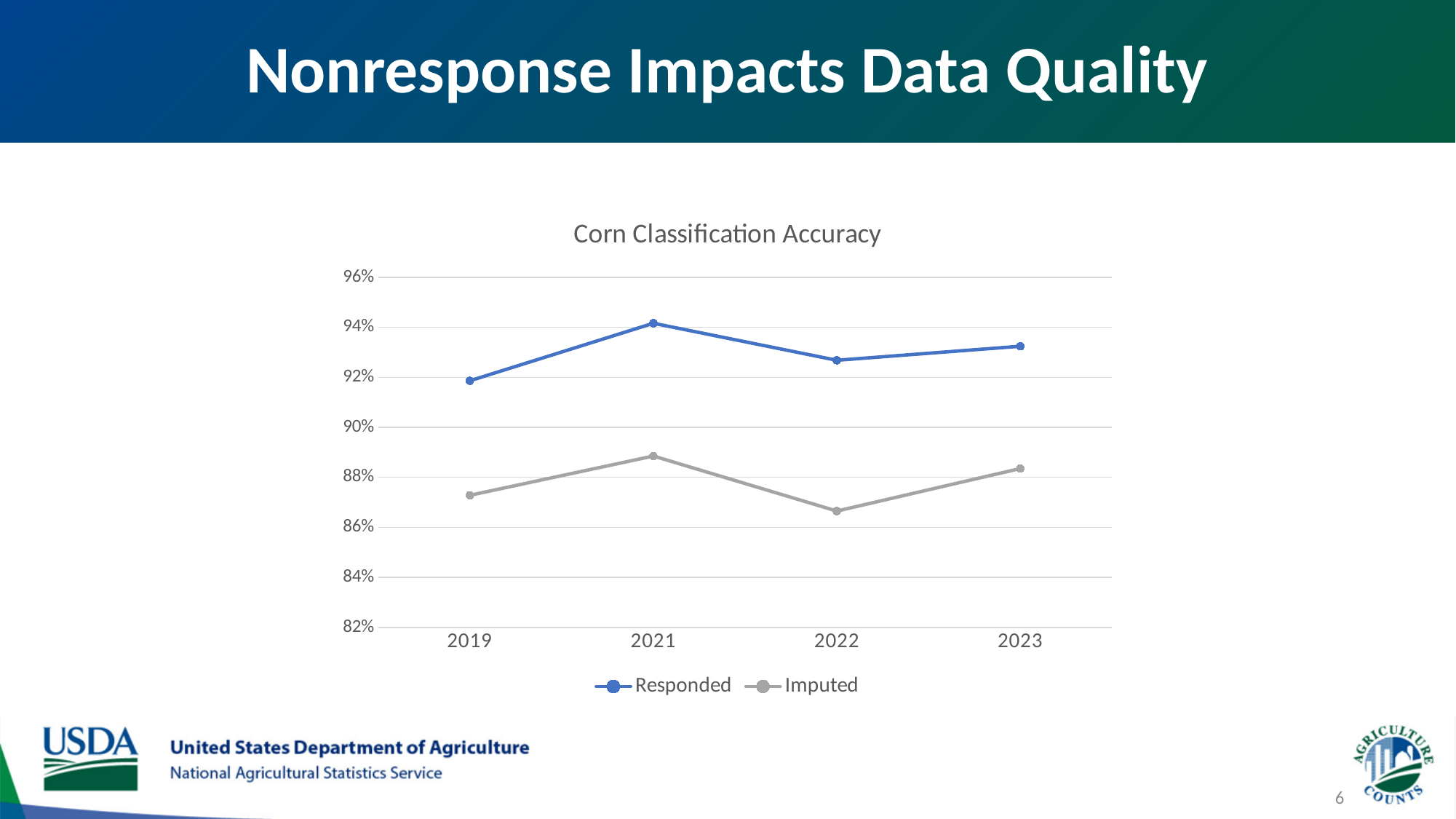
In which year is the Imputed series lowest? 2022 In 2023, which series has the higher value, Responded or Imputed? Responded What kind of chart is shown on the slide? line chart What is the title of the chart? Corn Classification Accuracy Does the Imputed series rise or fall from 2021 to 2022? fall Is the value for Imputed in 2022 greater or less than 88%? less Is the value for Responded in 2022 greater or less than 92%? greater How many series does the legend list? 2 In which year is the Responded series lowest? 2019 How many years are shown on the x axis? 4 Is the value for Imputed in 2021 greater or less than 88%? greater In which year is the Responded series highest? 2021